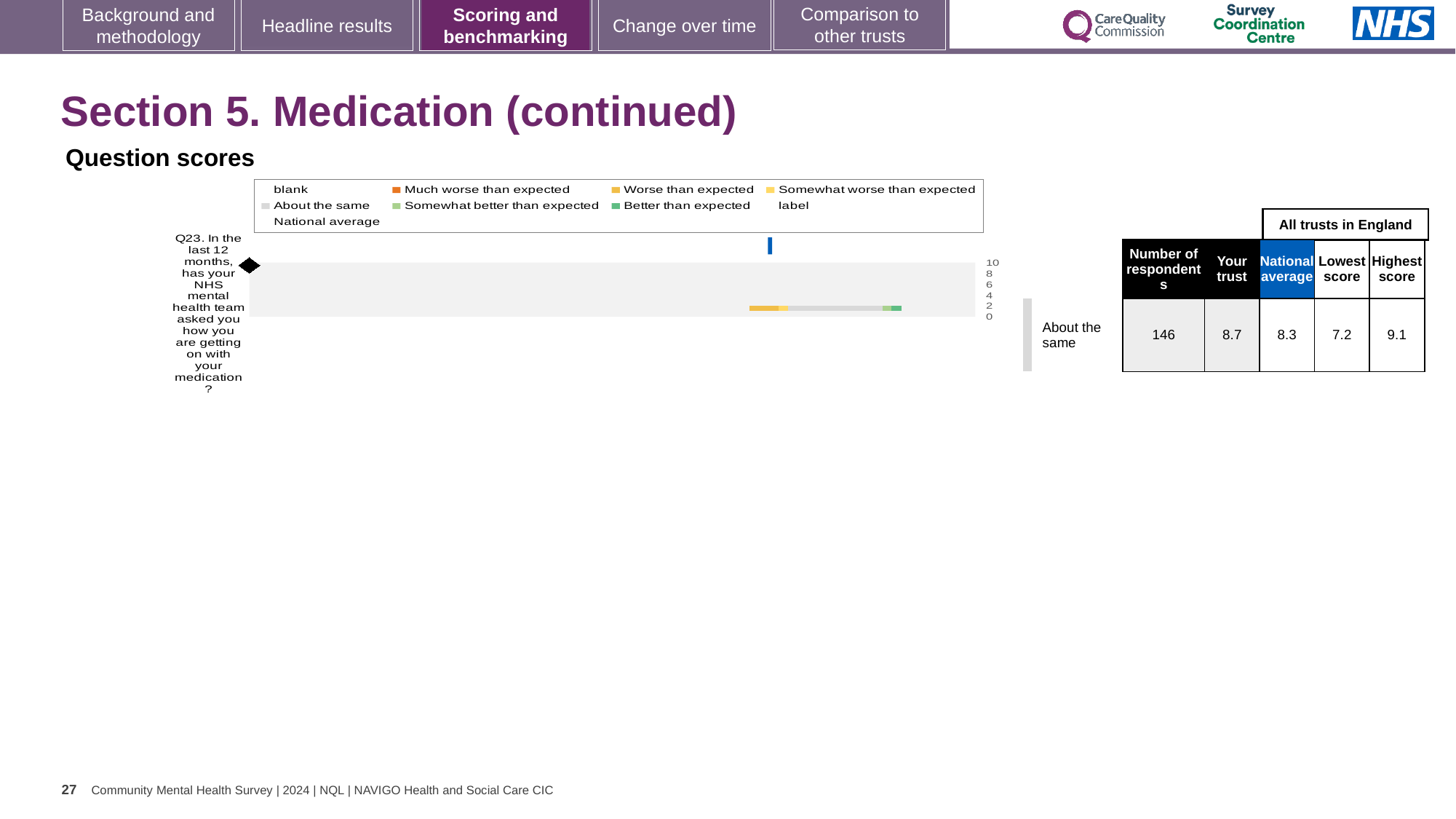
What is the highest value shown on the chart's axis? 10 Which benchmark category is shown for Q23 next to the chart? About the same What is the 'Your trust' score for Q23? 8.7 What is the lowest score among all trusts in England for Q23? 7.2 What kind of chart is used to show the Q23 question score? bar chart How many respondents answered Q23? 146 Which legend entry does the blue marker on the chart represent? National average Which is larger for Q23, the 'Your trust' score or the national average? Your trust What is the highest score among all trusts in England for Q23? 9.1 What is the national average score for Q23? 8.3 What is the difference between the 'Your trust' score and the national average for Q23? 0.4 How many survey questions are plotted in the chart? 1